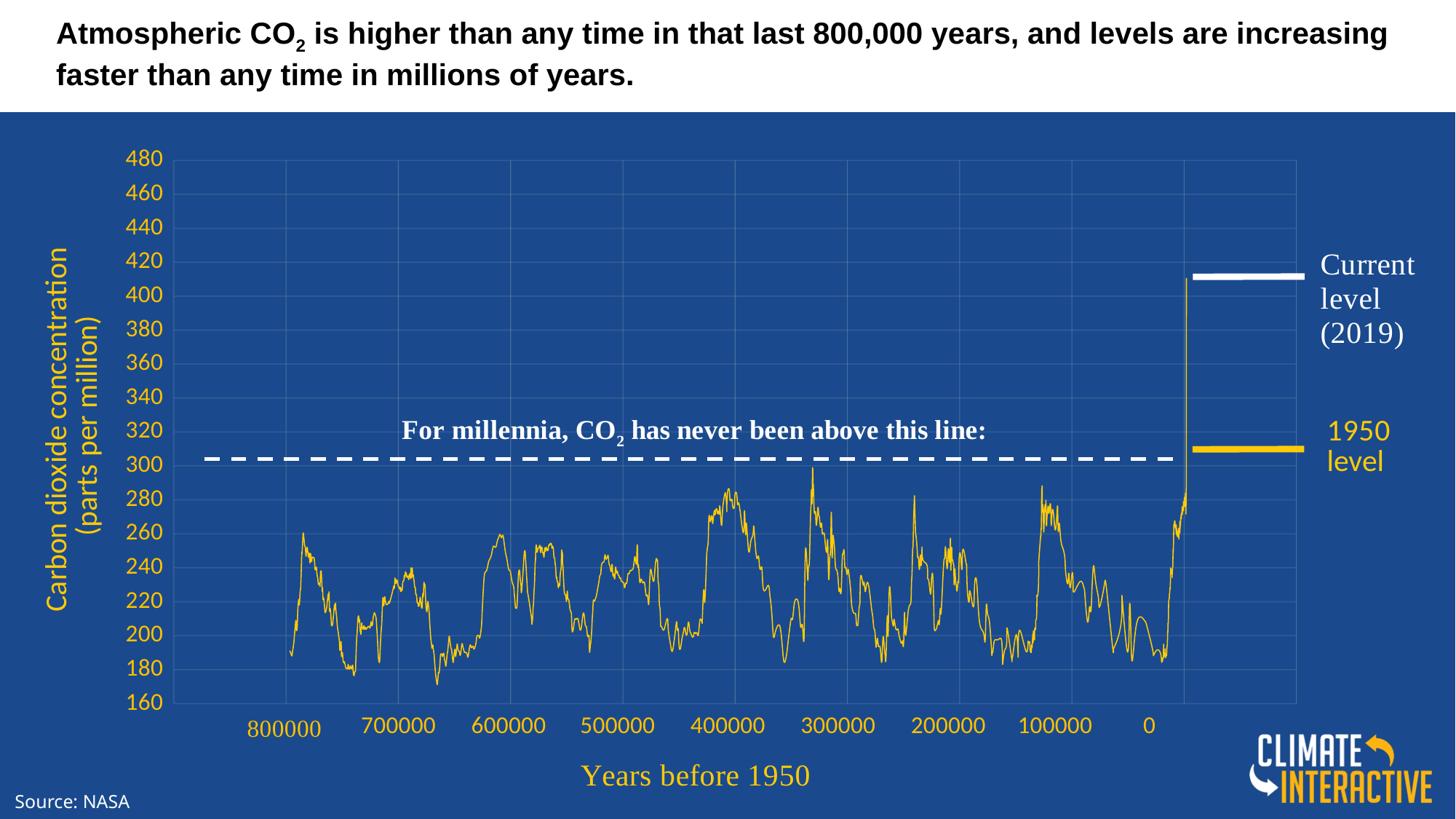
What is the title of the x axis of the chart? Years before 1950 What is the highest value on the y axis of the chart? 480 Is the CO2 concentration at 0 years before 1950 greater or less than 300 parts per million? less What kind of chart is shown on the slide? line chart Is the CO2 concentration at 800000 years before 1950 greater or less than 200 parts per million? less Is the current level (2019) of CO2 shown on the chart greater or less than 400 parts per million? greater Which is higher on the chart, the current level (2019) or the 1950 level? Current level (2019) Does the CO2 concentration line rise or fall at the far right end of the chart, after 0 years before 1950? rise